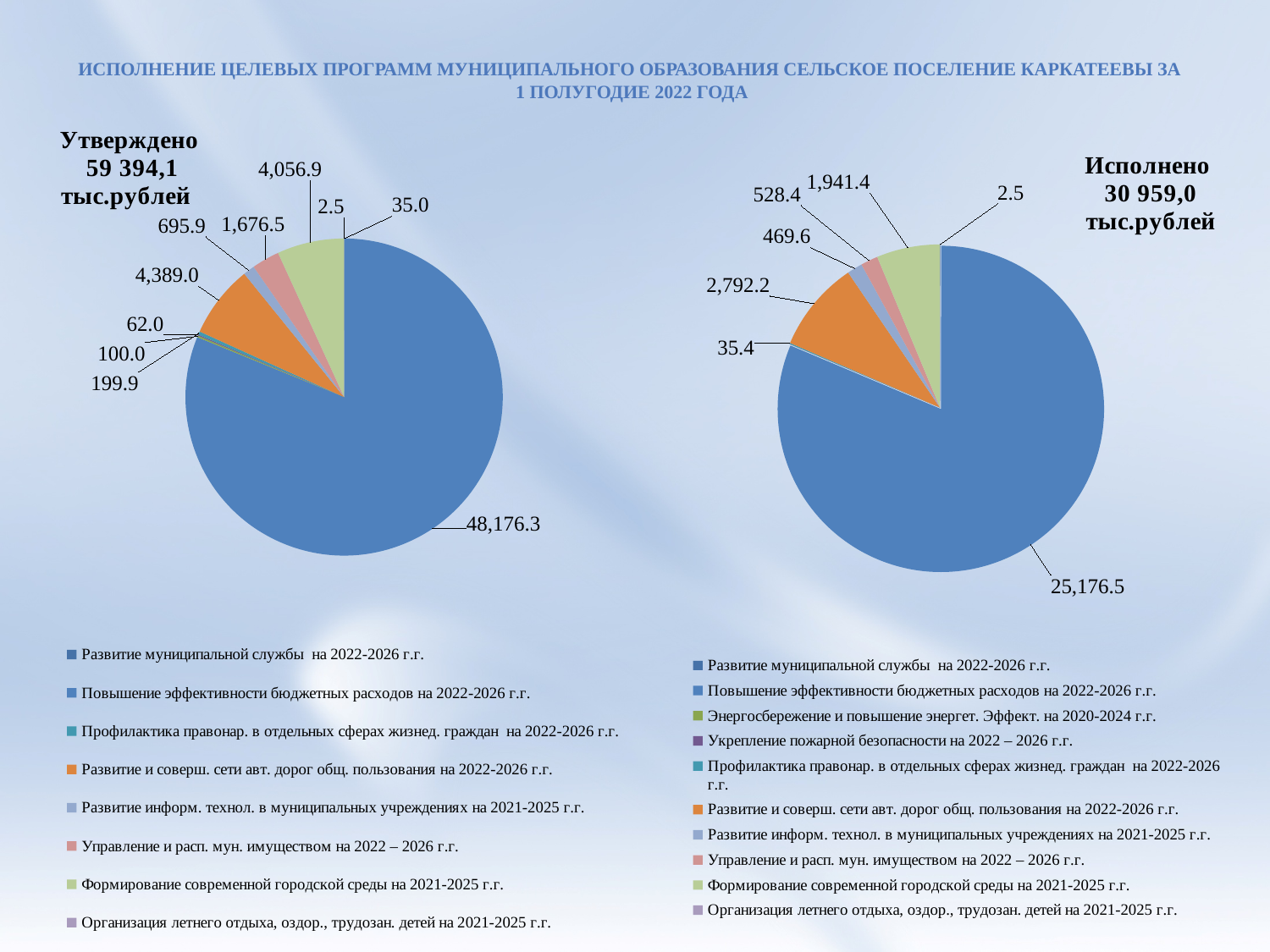
In the right pie chart (Исполнено), what is the value labelled for the light green slice (Формирование современной городской среды)? 1,941.4 In the right pie chart (Исполнено), what is the value labelled for the orange slice (Развитие и соверш. сети авт. дорог общ. пользования)? 2,792.2 Which is larger: the largest slice of the left pie chart (Утверждено) or the largest slice of the right pie chart (Исполнено)? the left chart (48,176.3) In the left pie chart (Утверждено), what is the value labelled for the orange slice (Развитие и соверш. сети авт. дорог общ. пользования)? 4,389.0 In the left pie chart (Утверждено), what is the value of the largest slice? 48,176.3 In the left pie chart (Утверждено), what is the smallest labelled value? 2.5 In the right pie chart (Исполнено), what is the value of the largest slice? 25,176.5 How many entries does the legend of the left pie chart (Утверждено) list? 8 In the left pie chart (Утверждено), what is the difference between the largest slice (48,176.3) and the orange slice (4,389.0)? 43,787.3 What type of chart is used on the left side of the slide (Утверждено)? pie chart What total amount is stated next to the right pie chart under the heading Исполнено? 30 959,0 тыс.рублей How many entries does the legend of the right pie chart (Исполнено) list? 10